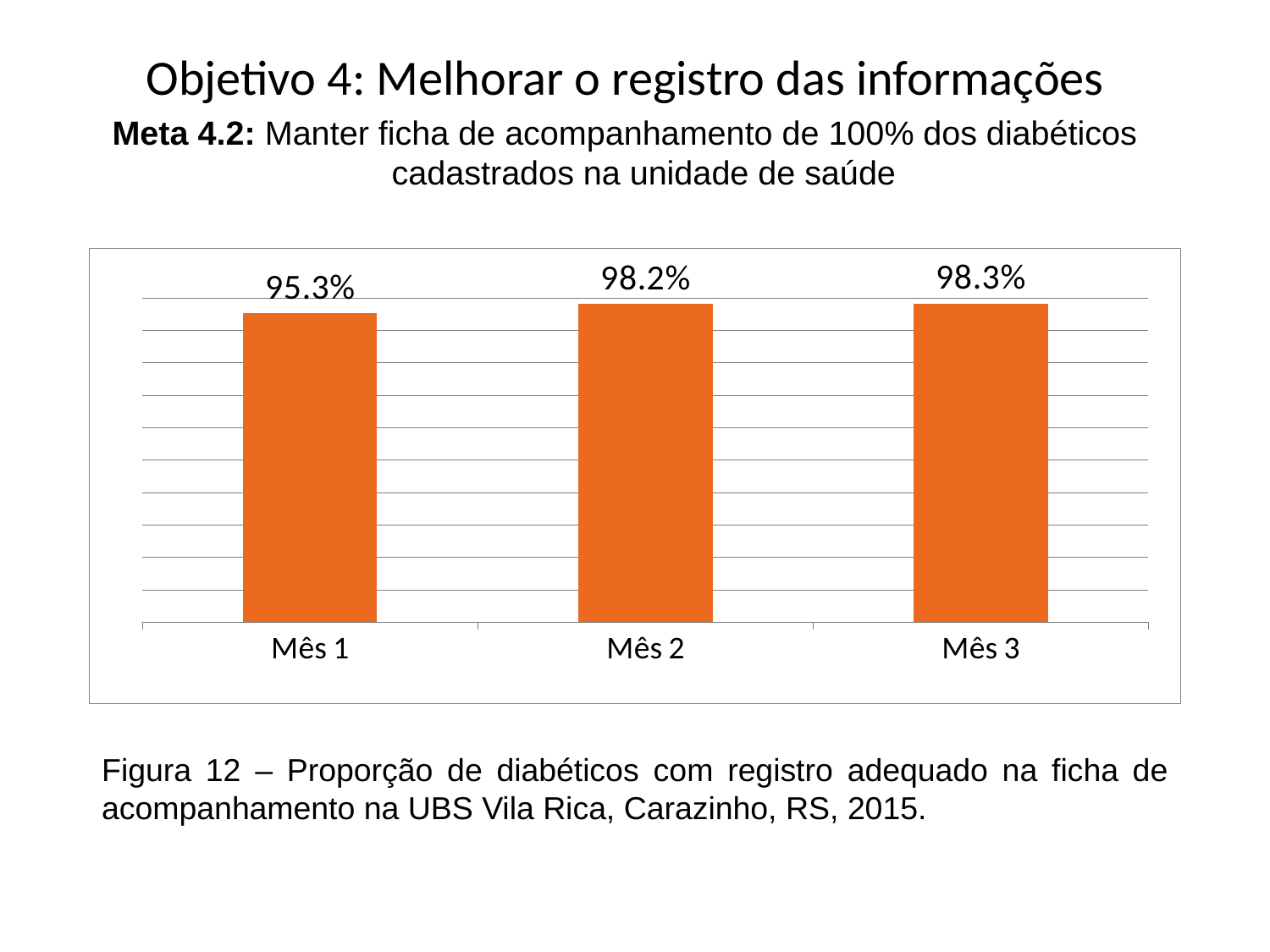
What kind of chart is shown on the slide? Bar chart Which month has the highest value? Mês 3 Which is larger, the value for Mês 1 or the value for Mês 2? Mês 2 What is the value for Mês 2? 98.2% What is the difference between the values for Mês 3 and Mês 1? 3.0 percentage points What is the value for Mês 3? 98.3% What is the difference between the values for Mês 2 and Mês 1? 2.9 percentage points What figure number is given in the caption below the chart? Figura 12 What is the value for Mês 1? 95.3% Which month has the lowest value? Mês 1 Do the values rise or fall from Mês 1 to Mês 3? Rise How many months are shown in the chart? 3